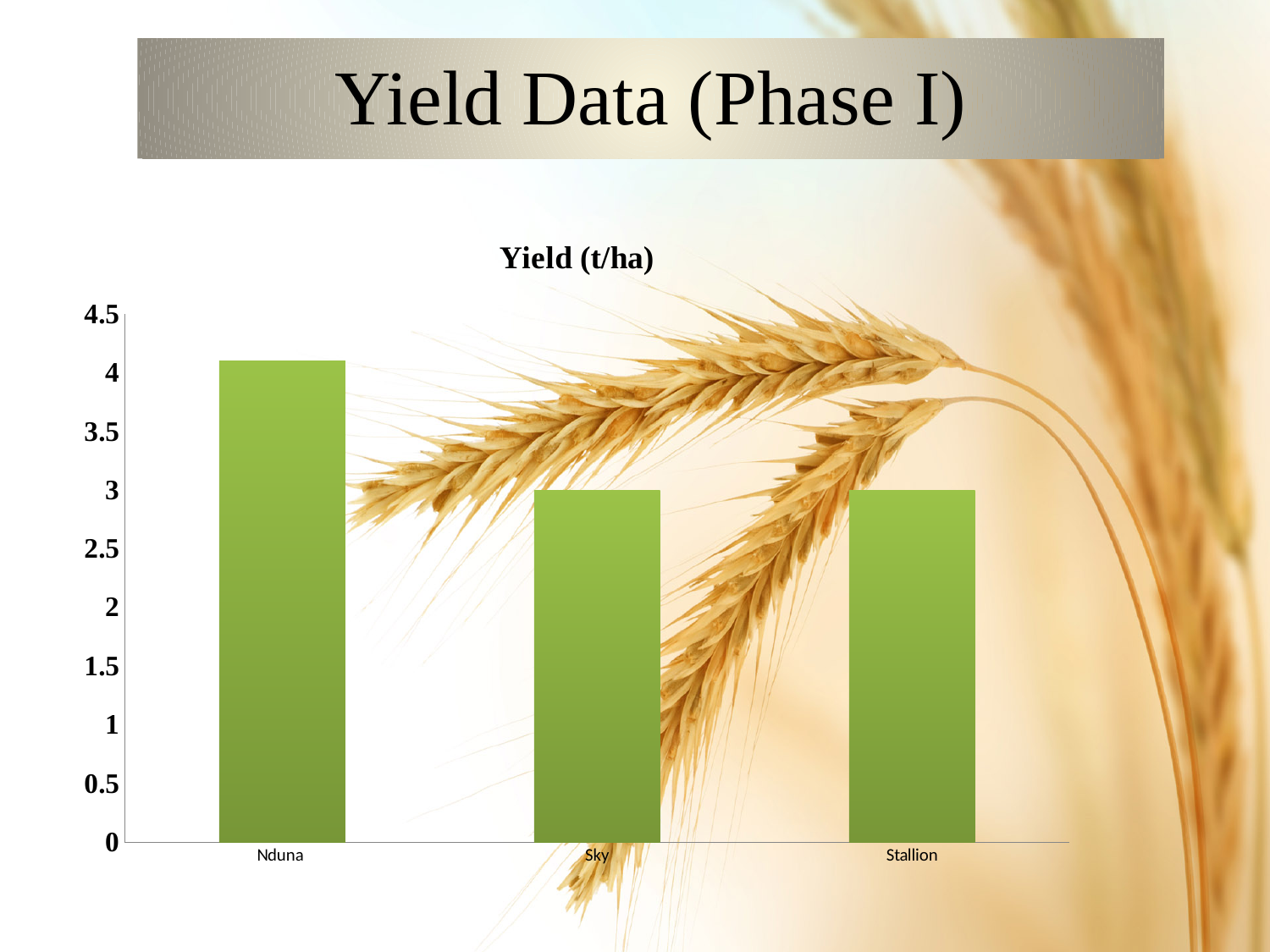
How many varieties are plotted on the chart? 3 What is the title of the chart? Yield (t/ha) Is the yield for Sky greater or less than 3.5? less What is the highest value shown on the vertical axis? 4.5 Which has a higher yield, Nduna or Sky? Nduna Is the yield for Stallion greater or less than 2.5? greater What is the yield value for Sky? 3 Is the yield for Nduna greater or less than 4? greater What is the yield value for Stallion? 3 What type of chart is shown on the slide? bar chart Which has a higher yield, Nduna or Stallion? Nduna Which variety has the highest yield? Nduna